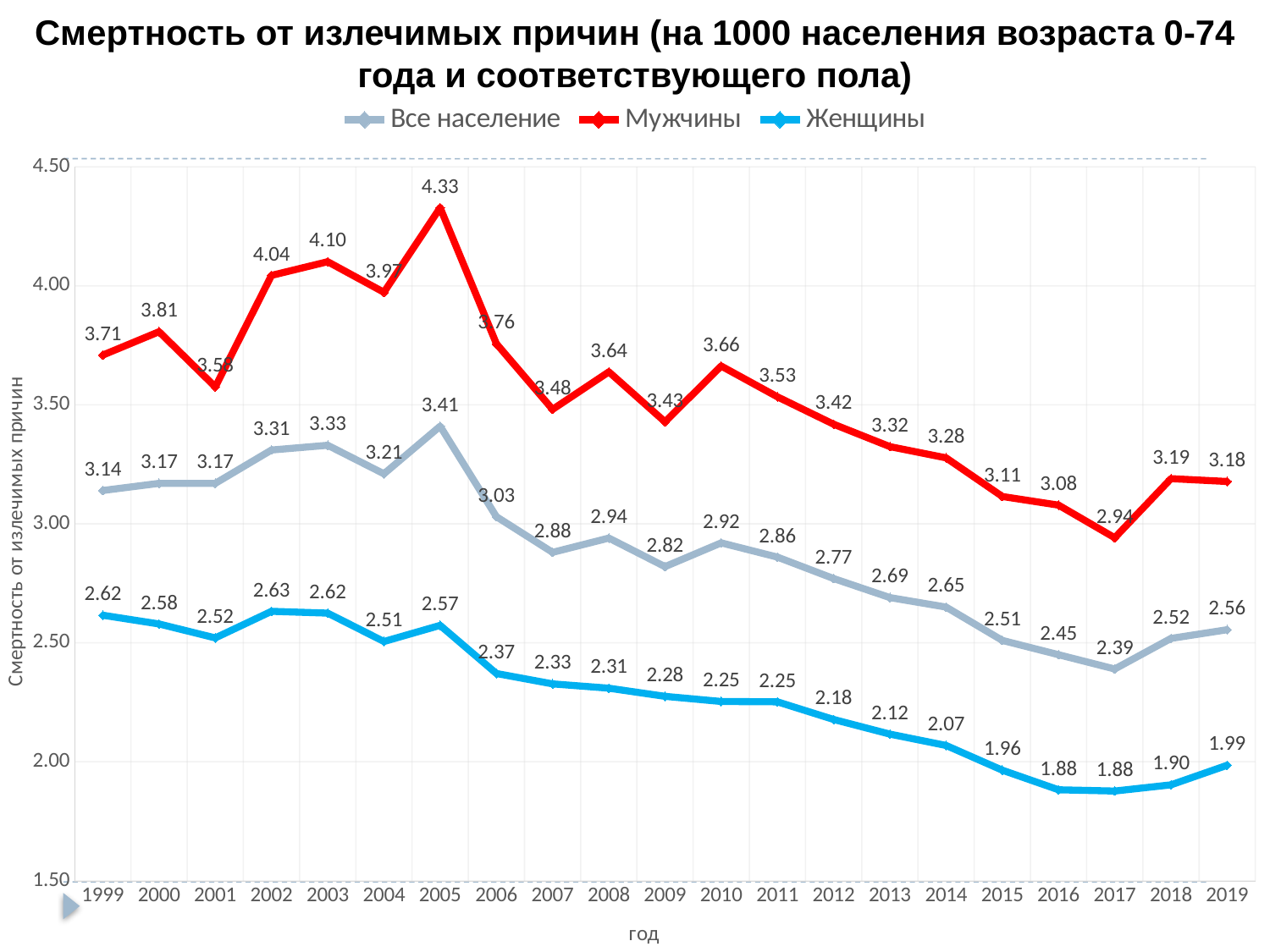
What is the difference between the Мужчины values in 2005 and 2019? 1.15 Which is larger: the Все население value in 2003 or in 2005? 2005 How many years are plotted along the x axis? 21 Which series is drawn in red? Мужчины What is the value for Женщины in 2019? 1.99 What kind of chart is shown on the slide? line chart In which year is the value for Мужчины highest? 2005 What is the value for Мужчины in 2005? 4.33 What is the value for Все население in 2010? 2.92 How many series does the legend list? 3 Does the Женщины series overall rise or fall from 1999 to 2019? fall In which year is the value for Все население lowest? 2017